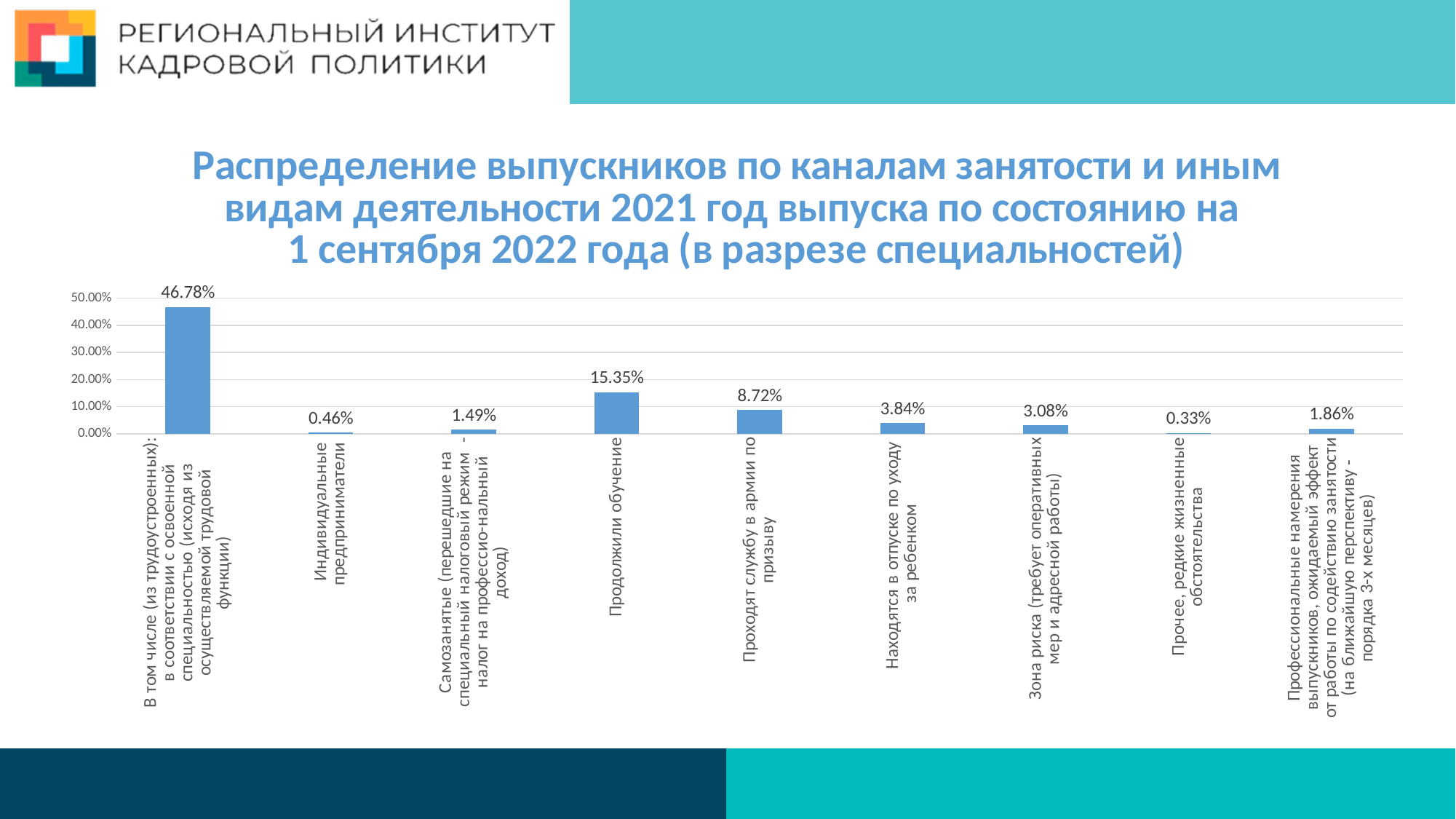
What is the difference between the values for "Продолжили обучение" and "Проходят службу в армии по призыву"? 6.63% What is the value for "Самозанятые (перешедшие на специальный налоговый режим - налог на профессио-нальный доход)"? 1.49% What is the value for "Проходят службу в армии по призыву"? 8.72% Which category has the highest value? В том числе (из трудоустроенных): в соответствии с освоенной специальностью (исходя из осуществляемой трудовой функции) What is the value for "Зона риска (требует оперативных мер и адресной работы)"? 3.08% What is the value for "Продолжили обучение"? 15.35% What kind of chart is shown on the slide? bar chart Which category has the lowest value? Прочее, редкие жизненные обстоятельства What is the value for "Индивидуальные предприниматели"? 0.46% Is the value for "Продолжили обучение" greater or less than 10.00%? greater Which is larger: the value for "Находятся в отпуске по уходу за ребенком" or the value for "Зона риска (требует оперативных мер и адресной работы)"? Находятся в отпуске по уходу за ребенком How many categories are shown on the chart? 9